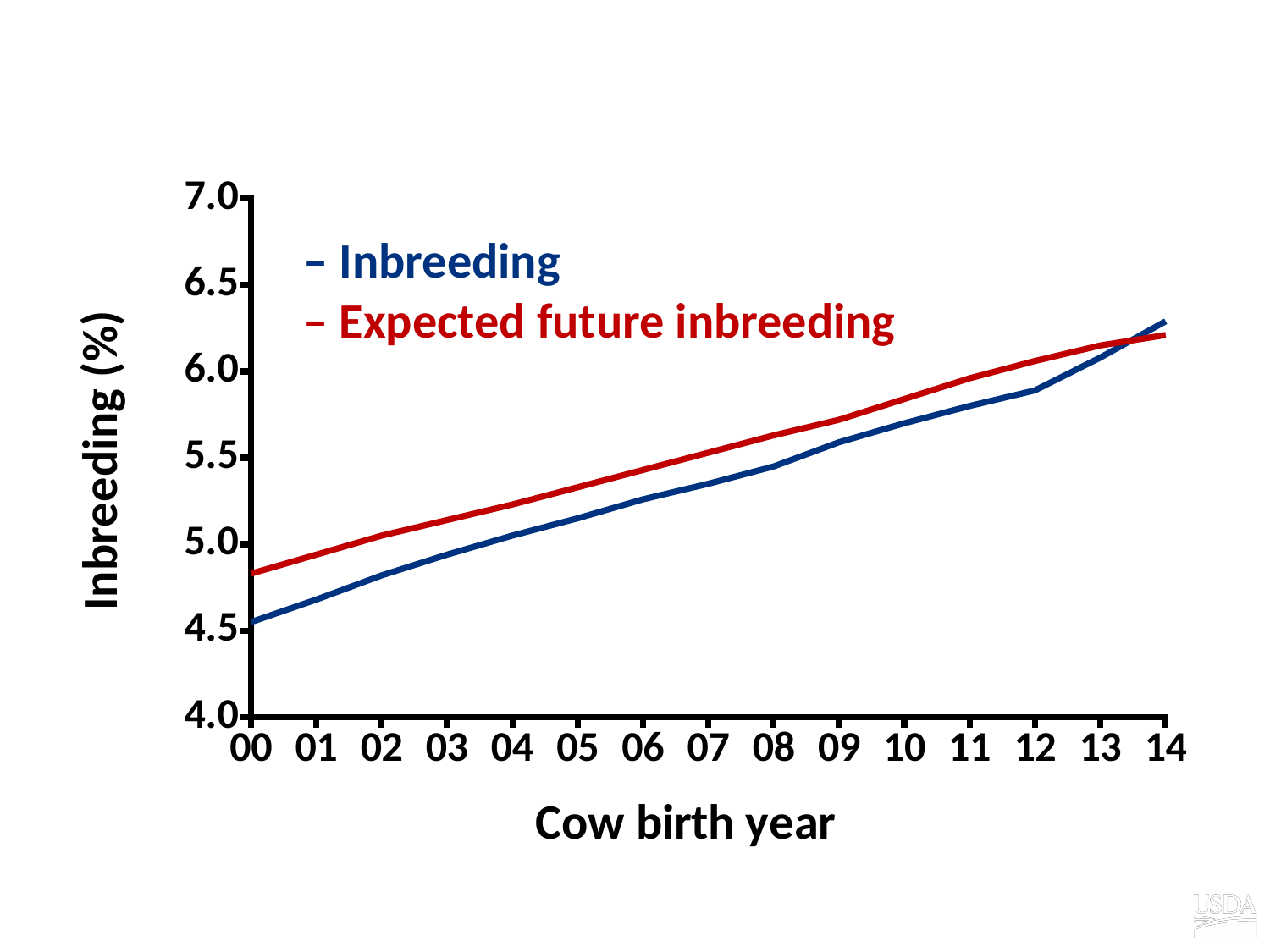
Is the Inbreeding value for birth year 00 greater or less than 5.0? less Is the Expected future inbreeding value for birth year 04 greater or less than 5.0? greater Does the Inbreeding line rise or fall from birth year 00 to 14? rise Does the Expected future inbreeding line rise or fall across the birth years? rise What is the title of the x axis? Cow birth year What kind of chart is shown on the slide? line chart Is the Inbreeding value for birth year 12 greater or less than 6.0? less At birth year 06, which series has the higher value, Inbreeding or Expected future inbreeding? Expected future inbreeding How many cow birth years are shown along the x axis? 15 How many series does the legend list? 2 At birth year 00, which series has the higher value, Inbreeding or Expected future inbreeding? Expected future inbreeding